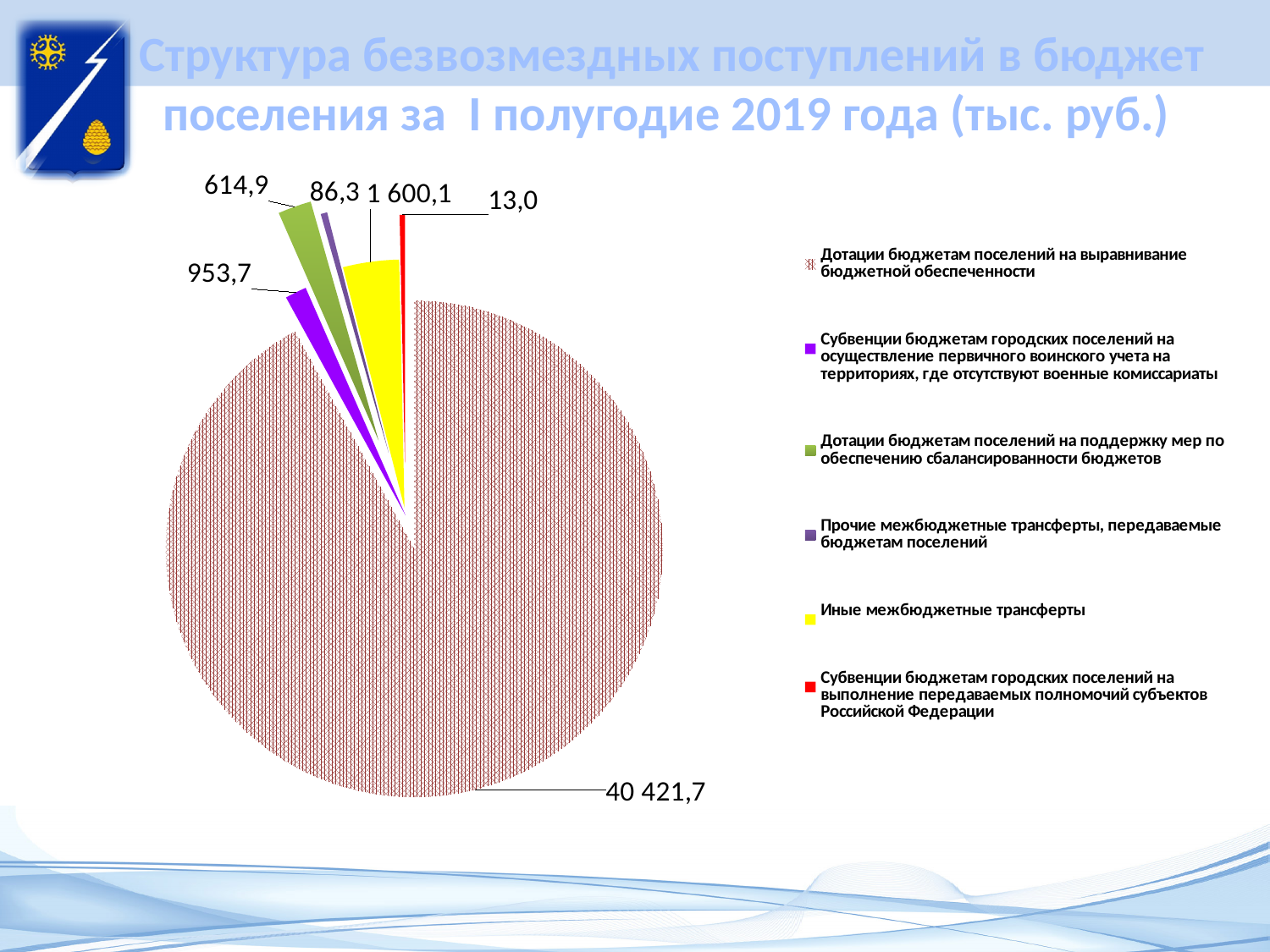
Which category has the largest value in the pie chart? Дотации бюджетам поселений на выравнивание бюджетной обеспеченности What is the value for «Дотации бюджетам поселений на выравнивание бюджетной обеспеченности»? 40 421,7 What is the difference between the value for «Иные межбюджетные трансферты» and the value for «Субвенции бюджетам городских поселений на осуществление первичного воинского учета»? 646,4 Which is larger: the value for «Дотации бюджетам поселений на поддержку мер по обеспечению сбалансированности бюджетов» or the value for «Прочие межбюджетные трансферты, передаваемые бюджетам поселений»? Дотации бюджетам поселений на поддержку мер по обеспечению сбалансированности бюджетов What is the value for «Субвенции бюджетам городских поселений на осуществление первичного воинского учета на территориях, где отсутствуют военные комиссариаты»? 953,7 What is the value for «Прочие межбюджетные трансферты, передаваемые бюджетам поселений»? 86,3 How many slices does the pie chart have? 6 What is the value for «Дотации бюджетам поселений на поддержку мер по обеспечению сбалансированности бюджетов»? 614,9 Which category has the smallest value in the pie chart? Субвенции бюджетам городских поселений на выполнение передаваемых полномочий субъектов Российской Федерации What kind of chart is shown on the slide? Pie chart What is the value for «Иные межбюджетные трансферты»? 1 600,1 How many entries does the legend list? 6